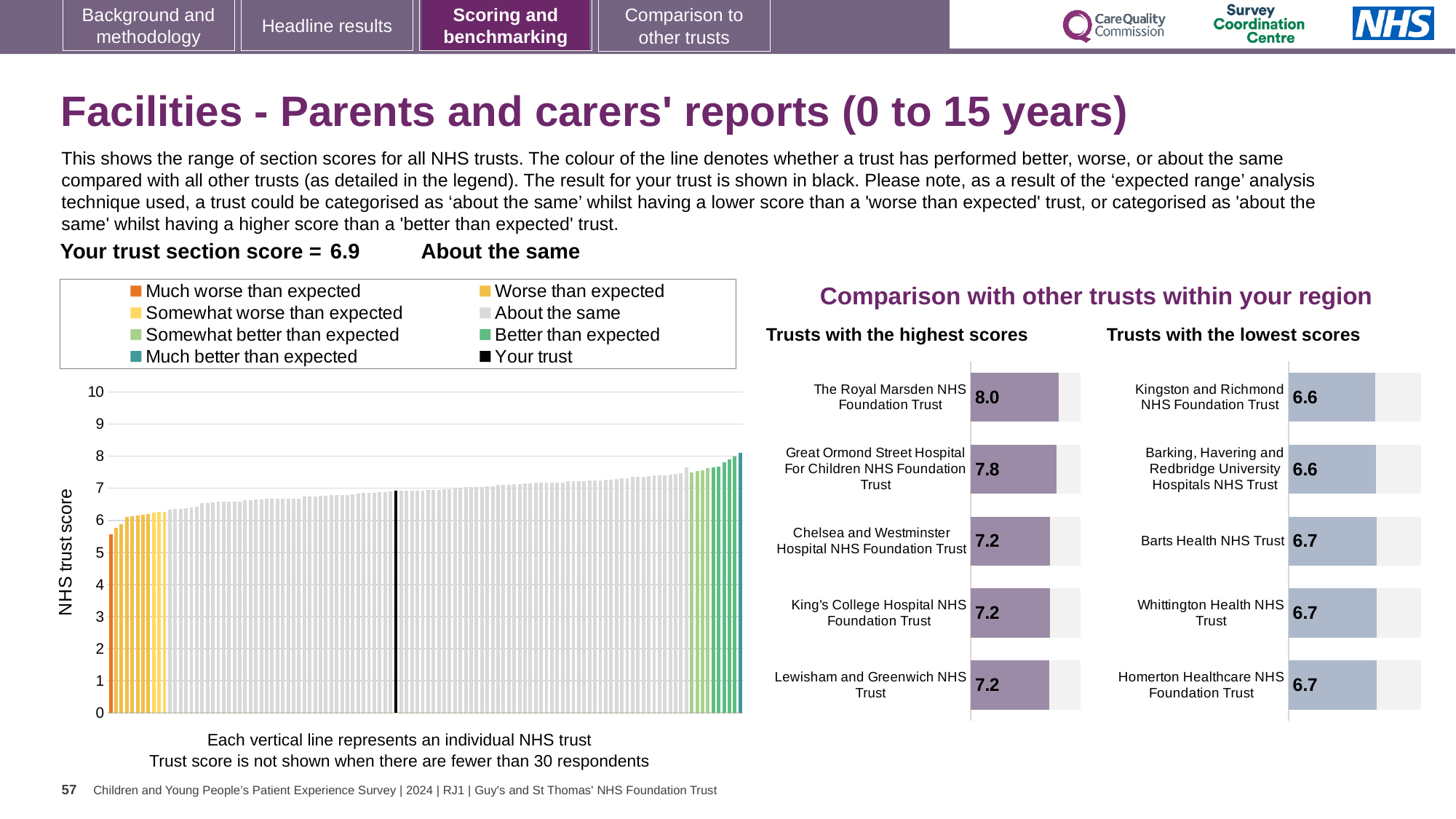
In the 'Trusts with the lowest scores' chart, what is the score for Barts Health NHS Trust? 6.7 What type of chart is the large chart on the left showing NHS trust scores? bar chart In the 'Trusts with the lowest scores' chart, what is the score for Kingston and Richmond NHS Foundation Trust? 6.6 In the 'Trusts with the highest scores' chart, which trust has the highest score? The Royal Marsden NHS Foundation Trust In the left chart of NHS trust scores, is the value of the lowest (leftmost) bar greater or less than 6? less In the 'Trusts with the highest scores' chart, what is the score for The Royal Marsden NHS Foundation Trust? 8.0 In the left chart of NHS trust scores, do the bars rise or fall from left to right? rise In the left chart of NHS trust scores, what is the section score for your trust (the black bar)? 6.9 Which is larger: the score for The Royal Marsden NHS Foundation Trust in the highest scores chart or the score for Homerton Healthcare NHS Foundation Trust in the lowest scores chart? The Royal Marsden NHS Foundation Trust How many trusts are shown in the 'Trusts with the highest scores' chart? 5 In the 'Trusts with the highest scores' chart, what is the difference between The Royal Marsden NHS Foundation Trust and Great Ormond Street Hospital For Children NHS Foundation Trust? 0.2 How many categories does the legend above the left chart list? 8